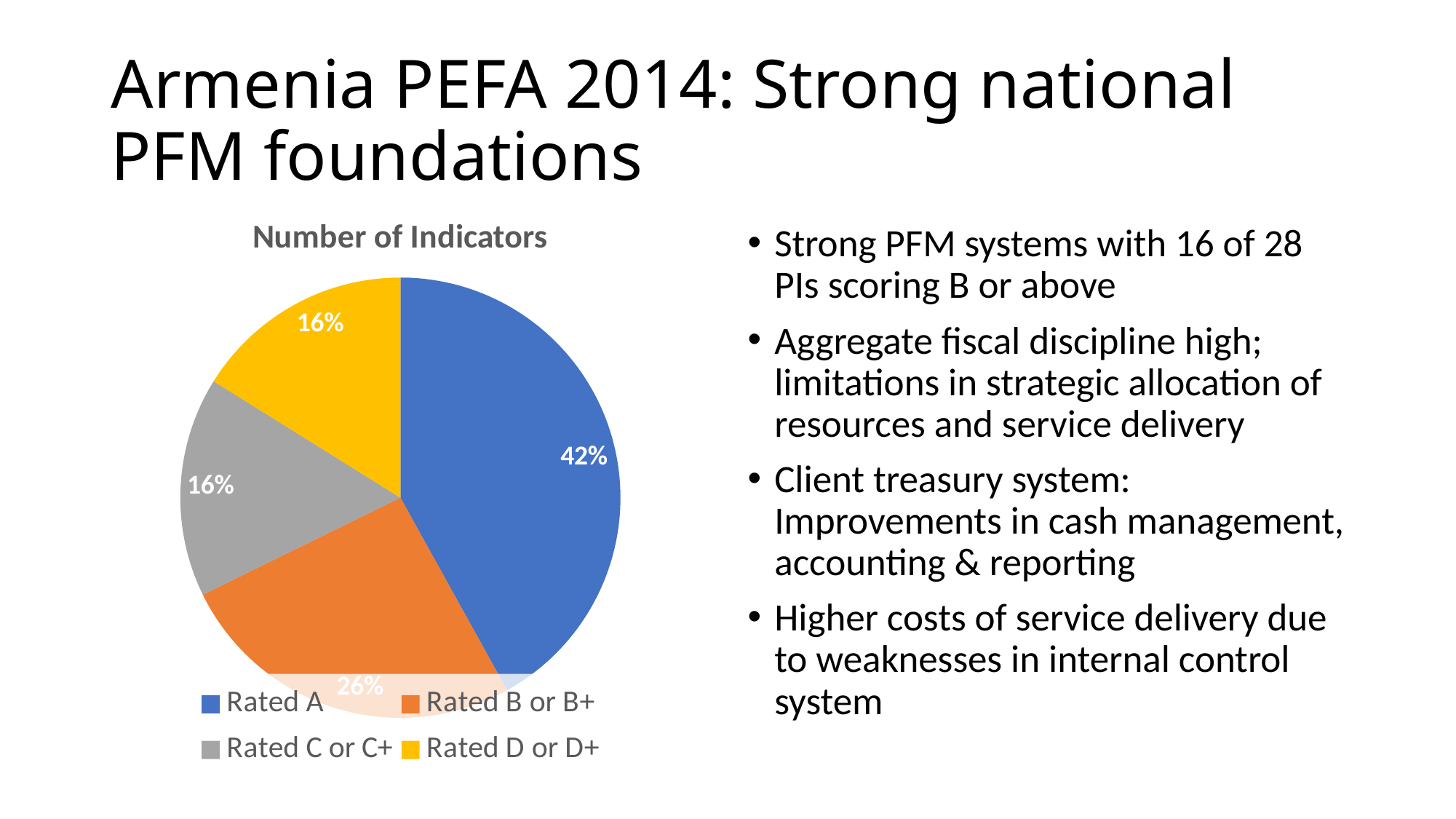
What kind of chart is shown on the slide? Pie chart Which is larger, the Rated B or B+ slice or the Rated C or C+ slice? Rated B or B+ What share of the pie does Rated C or C+ represent? 16% How many categories does the pie chart show? 4 Which category has the largest slice of the pie? Rated A What colour is the Rated D or D+ slice? Yellow What share of the pie does Rated B or B+ represent? 26% What is the title of the chart? Number of Indicators What share of the pie does Rated D or D+ represent? 16% What is the combined share of the Rated A and Rated B or B+ slices? 68% What is the difference in percentage points between the Rated A slice and the Rated B or B+ slice? 16